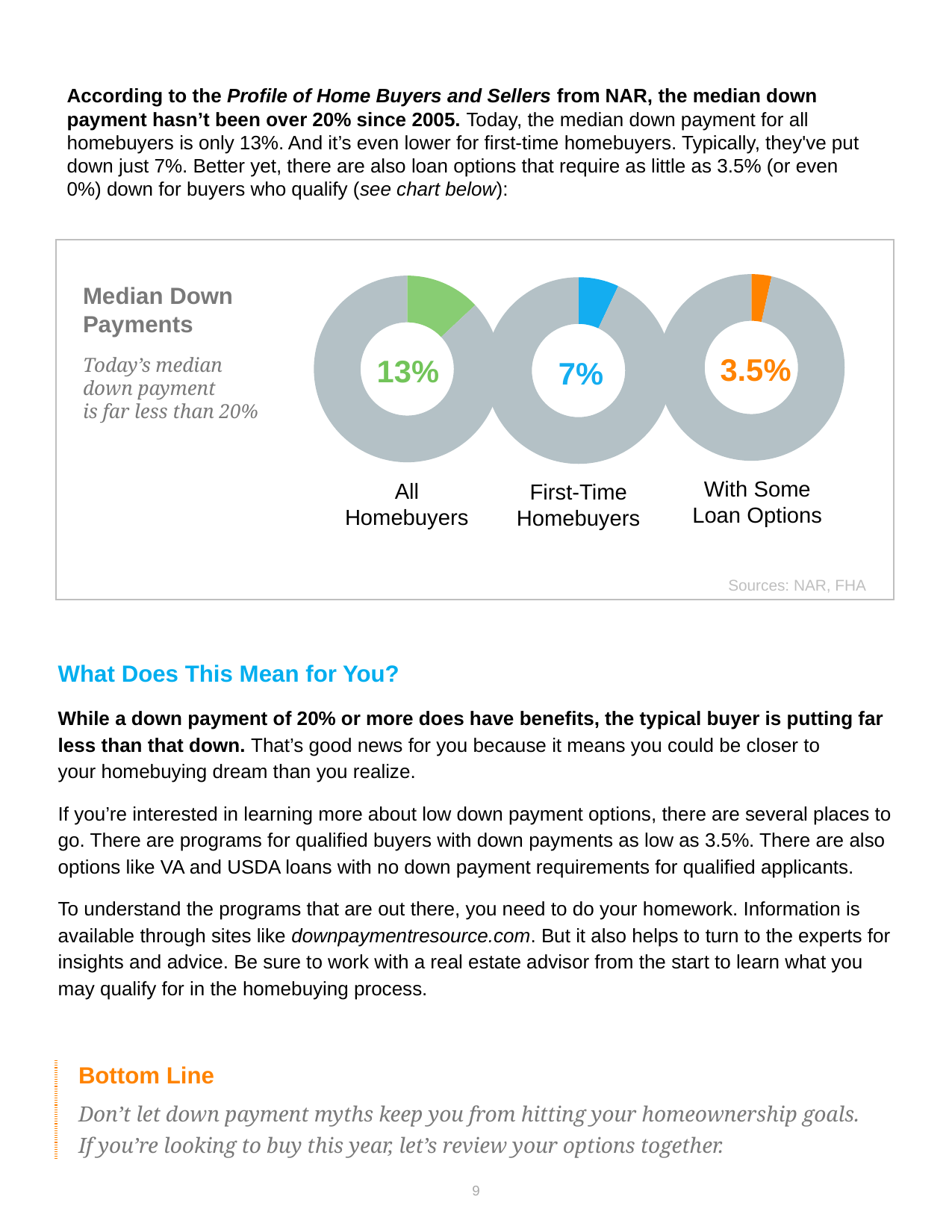
In the Median Down Payments chart, what is the median down payment for All Homebuyers? 13% How many donut charts are shown in the Median Down Payments graphic? 3 In the Median Down Payments chart, which category has the highest median down payment? All Homebuyers What is the title of the chart on the slide? Median Down Payments In the Median Down Payments chart, what is the down payment shown for With Some Loan Options? 3.5% What kind of chart is used to show the Median Down Payments? Donut chart In the Median Down Payments chart, what is the difference between the down payment for All Homebuyers and First-Time Homebuyers? 6% In the Median Down Payments chart, what is the difference between the down payment for First-Time Homebuyers and With Some Loan Options? 3.5% What sources are cited for the Median Down Payments chart? NAR, FHA In the Median Down Payments chart, what is the median down payment for First-Time Homebuyers? 7% In the Median Down Payments chart, which category has the lowest down payment? With Some Loan Options In the Median Down Payments chart, which is larger: the down payment for First-Time Homebuyers or With Some Loan Options? First-Time Homebuyers